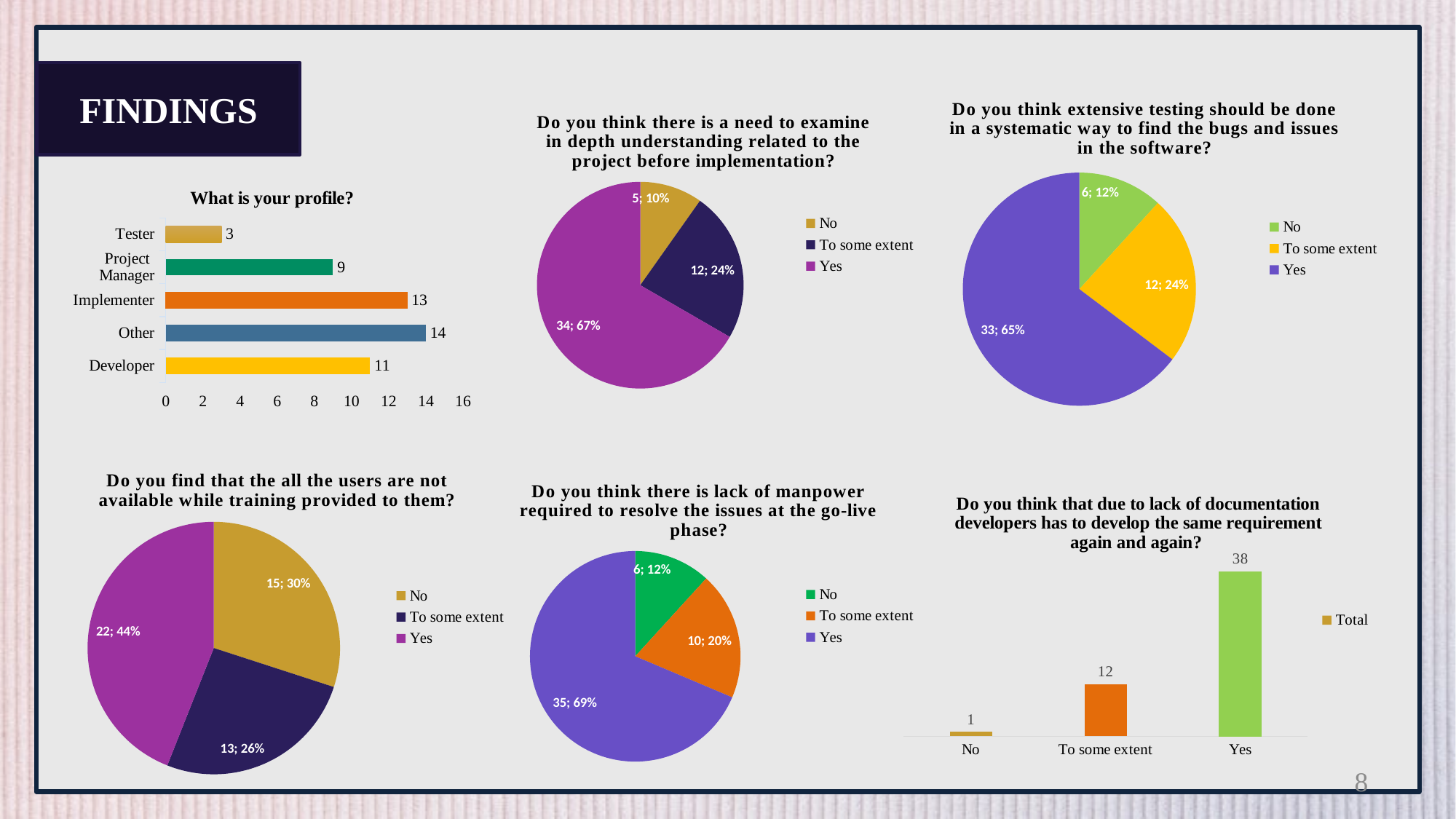
What kind of chart is 'What is your profile?' bar chart In the 'What is your profile?' chart, which category has the highest value? Other In the pie chart 'Do you think there is a need to examine in depth understanding related to the project before implementation?', what share does Yes have? 67% In the pie chart 'Do you think there is lack of manpower required to resolve the issues at the go-live phase?', what is the value for No? 6; 12% In the 'What is your profile?' chart, what is the difference between the values for Other and Developer? 3 In the 'What is your profile?' chart, how many categories are shown? 5 In the 'What is your profile?' chart, which category has the lowest value? Tester In the pie chart 'Do you find that the all the users are not available while training provided to them?', which slice is the largest? Yes In the pie chart 'Do you think extensive testing should be done in a systematic way to find the bugs and issues in the software?', what is the value for To some extent? 12; 24% In the chart 'Do you think that due to lack of documentation developers has to develop the same requirement again and again?', what is the difference between Yes and To some extent? 26 In the 'What is your profile?' chart, what is the value for Implementer? 13 How many series does the legend list in the chart 'Do you think that due to lack of documentation developers has to develop the same requirement again and again?' 1